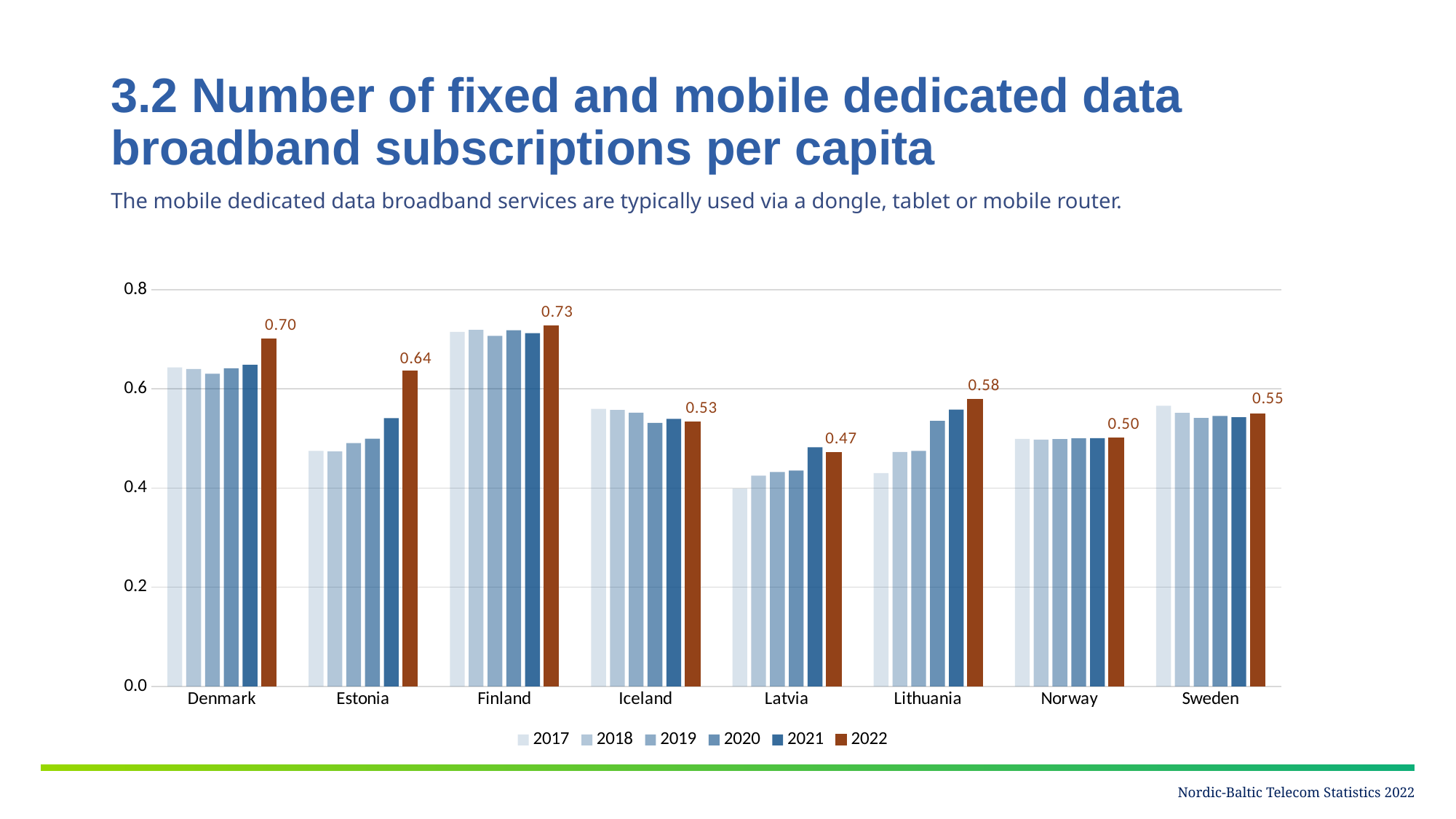
What kind of chart is shown on the slide? bar chart Is the 2017 value for Latvia greater or less than 0.6? less Which country has the lowest 2022 value? Latvia Which country has the highest 2022 value? Finland Is the 2017 value for Finland greater or less than 0.6? greater What is the 2022 value for Estonia? 0.64 What is the 2022 value for Latvia? 0.47 Which is larger, the 2022 value for Lithuania or the 2022 value for Sweden? Lithuania What is the difference between the 2022 values for Denmark and Norway? 0.20 What is the 2022 value for Finland? 0.73 How many countries are shown on the x axis? 8 How many series does the legend list? 6